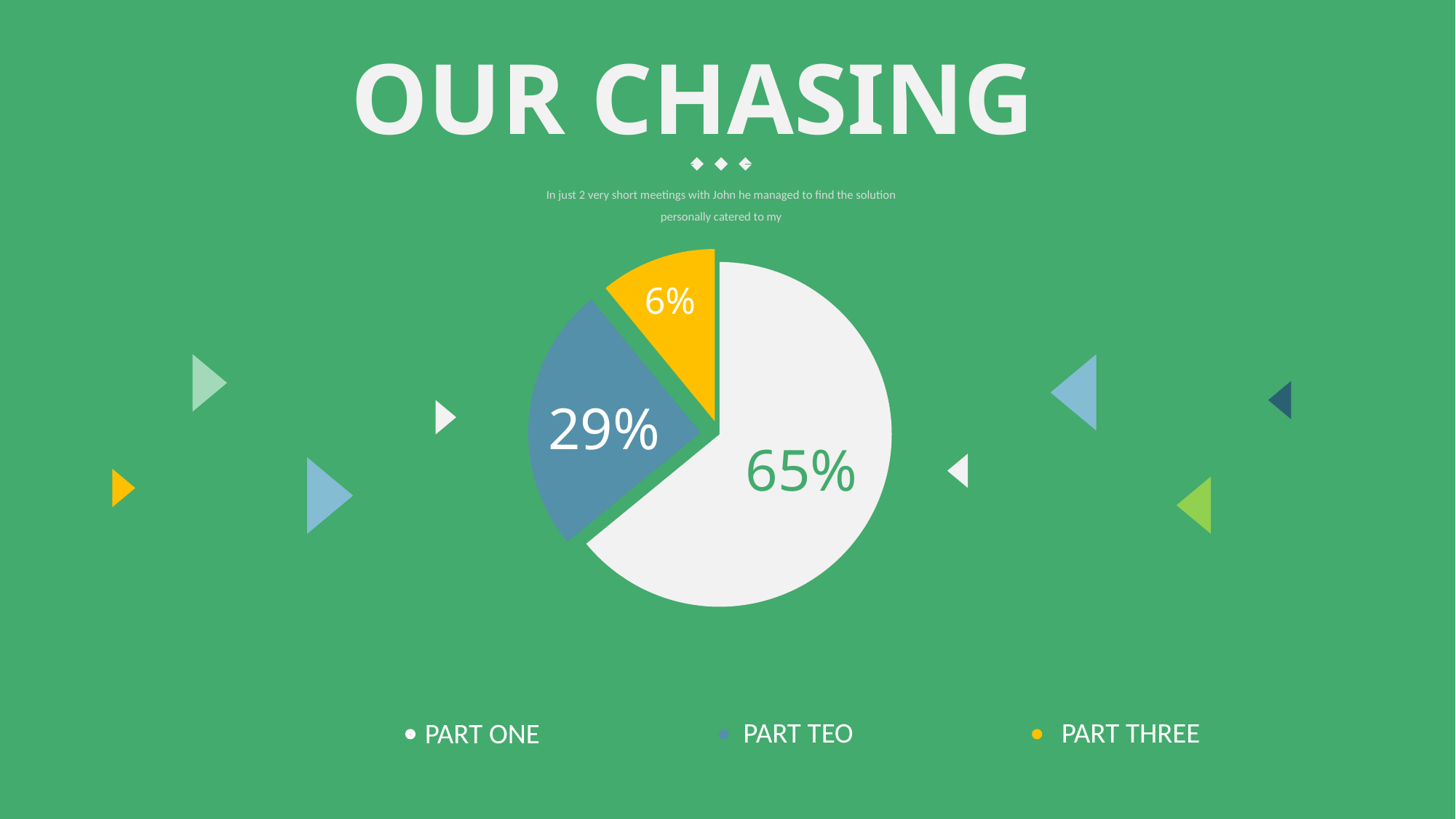
What percentage is shown for PART TEO? 29% What percentage is shown for PART THREE? 6% What is the difference between the PART ONE and PART TEO percentages? 36% Which is larger, PART TEO or PART THREE? PART TEO What kind of chart is shown on the slide? pie chart What colour is the PART THREE slice? yellow What percentage is shown for PART ONE? 65% How many slices does the pie chart have? 3 What is the difference between the PART TEO and PART THREE percentages? 23% Which slice of the pie is the smallest? PART THREE What is the title of the slide containing the pie chart? OUR CHASING Which slice of the pie is the largest? PART ONE